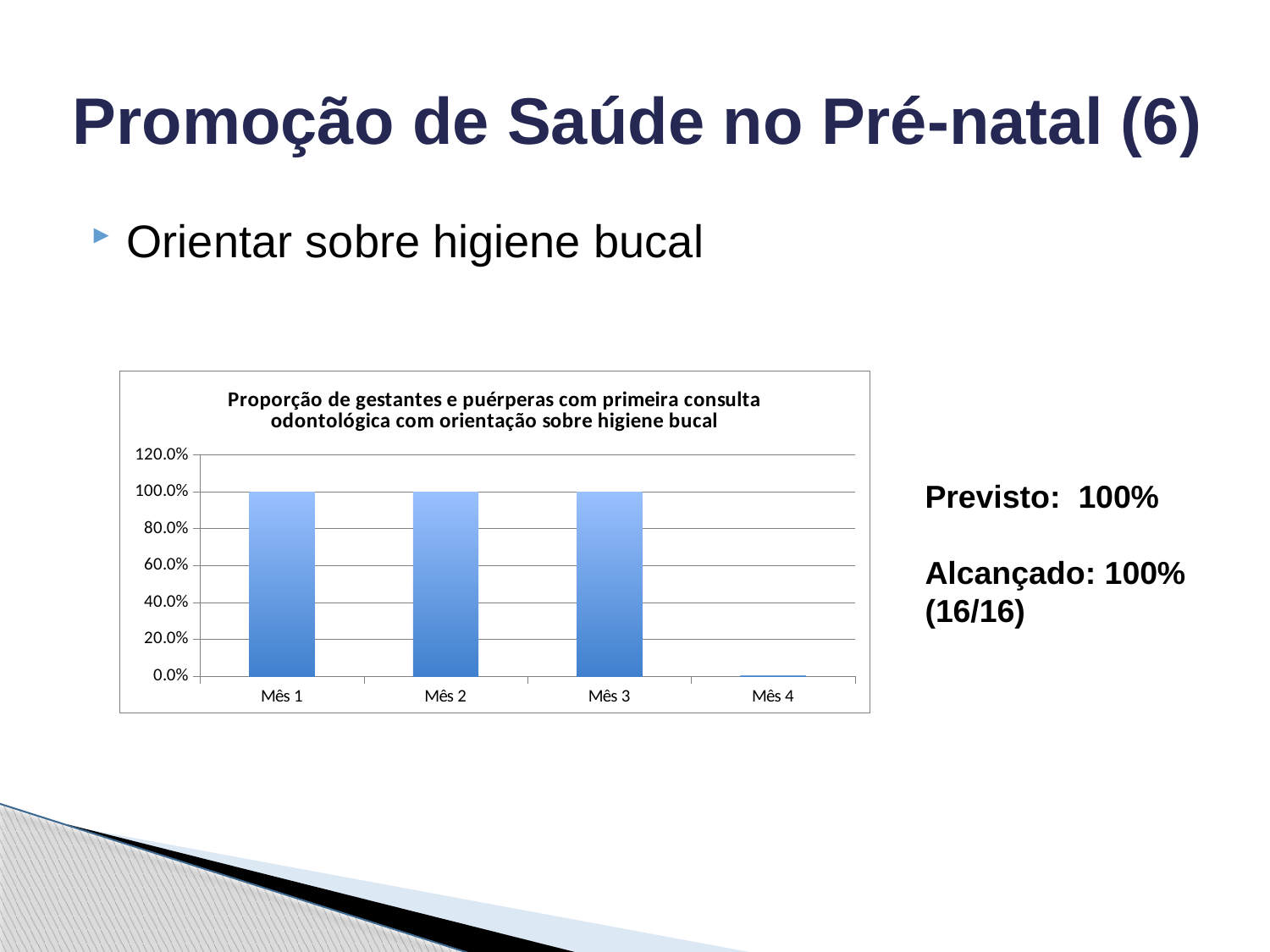
What is the value for Mês 2 in the chart? 100.0% How many categories are shown on the x axis of the chart? 4 Which is larger, the value for Mês 3 or the value for Mês 4? Mês 3 What is the highest value shown on the y axis of the chart? 120.0% What is the value for Mês 3 in the chart? 100.0% Is the value for Mês 4 greater or less than 20.0%? less What is the difference between the values for Mês 1 and Mês 3? 0.0% Which category has the lowest value in the chart? Mês 4 What is the value for Mês 1 in the chart? 100.0% What kind of chart is shown on the slide? bar chart Is the value for Mês 2 greater or less than 80.0%? greater What is the title of the chart? Proporção de gestantes e puérperas com primeira consulta odontológica com orientação sobre higiene bucal